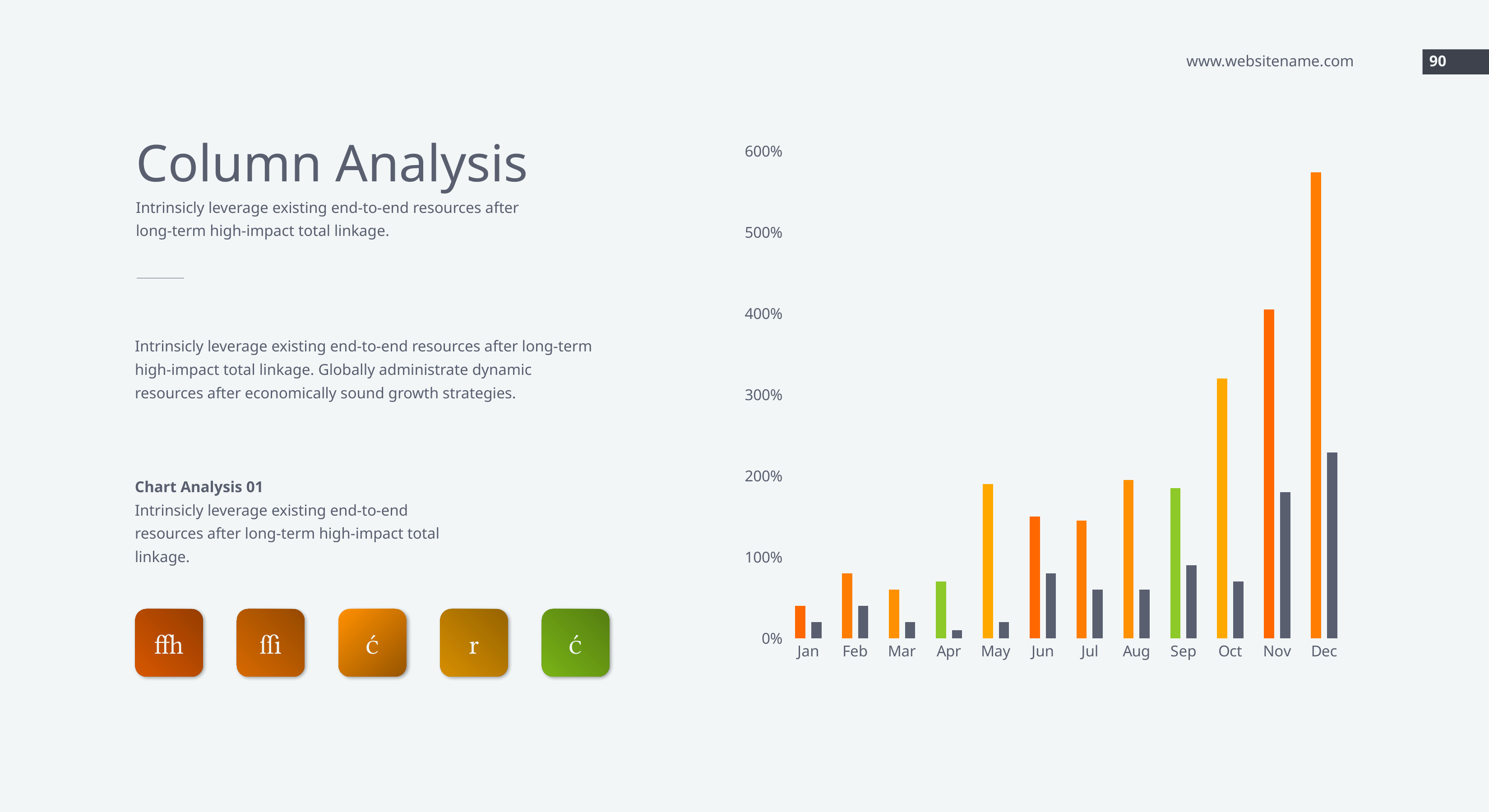
What kind of chart is shown on the slide? bar chart Is the coloured bar for Dec greater or less than 500%? greater Is the grey bar for Dec greater or less than 300%? less Is the coloured bar for Nov greater or less than 500%? less Which month has the tallest bar in the chart? Dec How many months are shown on the x axis of the chart? 12 How many bars are plotted for each month in the chart? 2 Which is taller, the coloured bar for Nov or the coloured bar for Oct? Nov Do the coloured bars generally rise or fall from Jan to Dec? rise Which month has the shortest coloured (first) bar in the chart? Jan